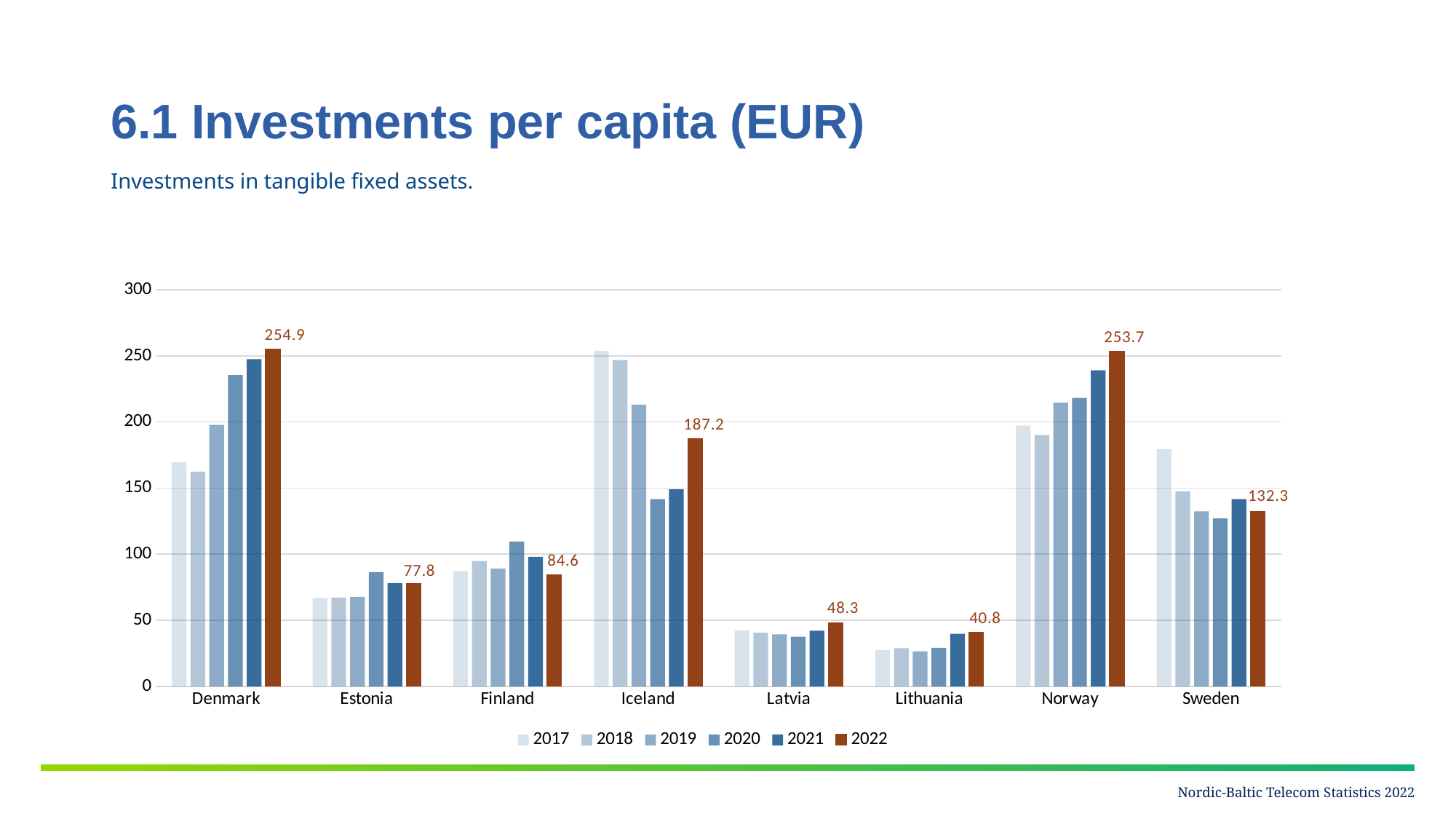
How many countries are shown on the x axis? 8 What kind of chart is shown on the slide? bar chart Which country has the lowest 2022 investment per capita? Lithuania What is the 2022 value shown for Iceland? 187.2 Is the 2017 value for Lithuania greater or less than 50? less What is the difference between the 2022 values for Iceland and Sweden? 54.9 Which country has the highest 2022 investment per capita? Denmark How many years does the legend list? 6 What is the 2022 value shown for Lithuania? 40.8 Which is larger, the 2022 value for Finland or the 2022 value for Estonia? Finland What is the 2022 investment per capita for Denmark? 254.9 What is the 2022 value shown for Sweden? 132.3